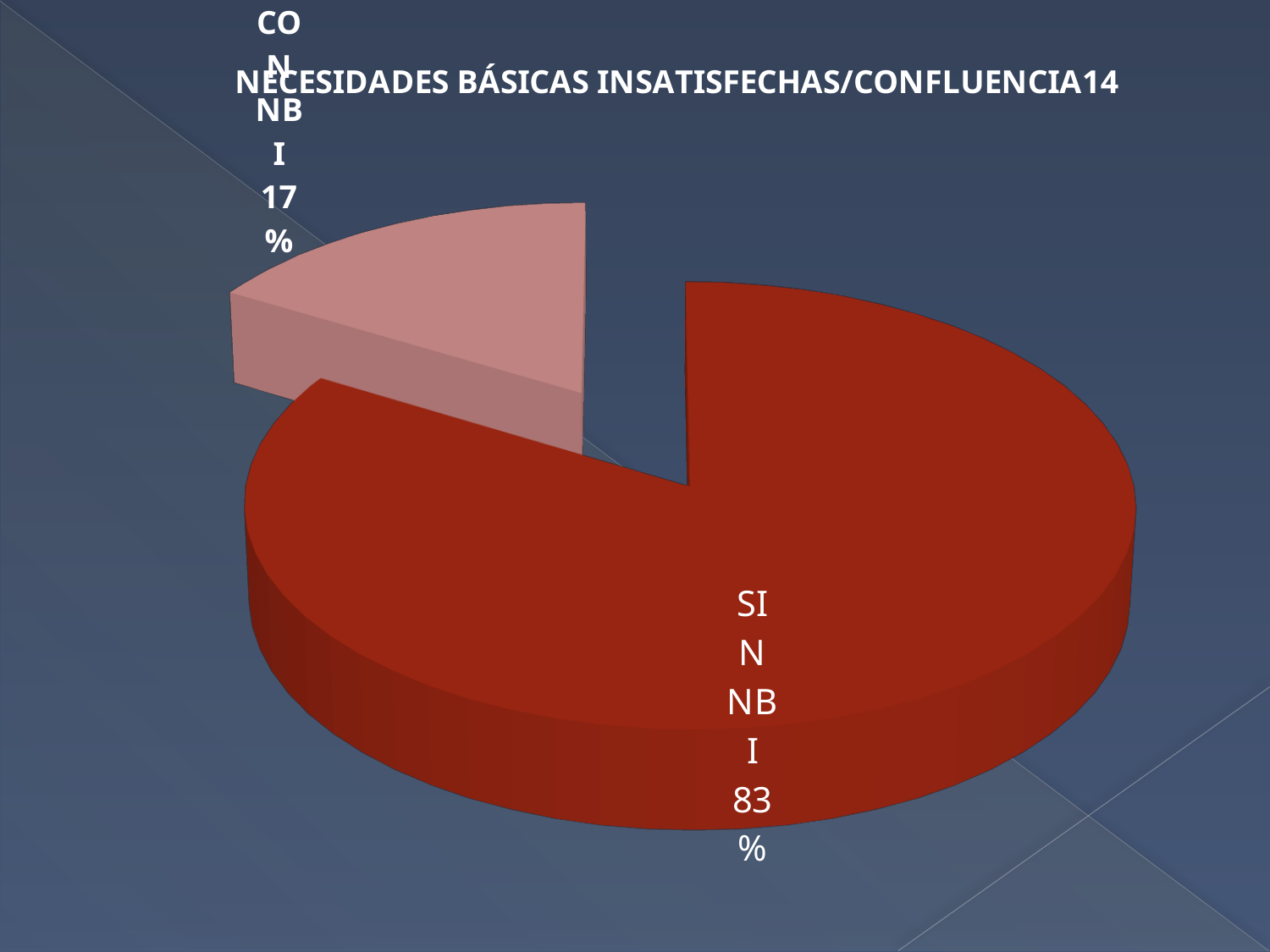
What is the difference in percentage points between SIN NBI and CON NBI? 66 What share of the pie does the CON NBI slice represent? 17% Which slice is the smallest in the pie chart? CON NBI Which slice is the largest in the pie chart? SIN NBI What is the title of the chart? NECESIDADES BÁSICAS INSATISFECHAS/CONFLUENCIA14 What kind of chart is shown on the slide? Pie chart What percentage is shown for CON NBI? 17% How many slices does the pie chart have? 2 Which is larger, the share for CON NBI or the share for SIN NBI? SIN NBI What colour is the SIN NBI slice? Dark red What percentage is shown for SIN NBI? 83%